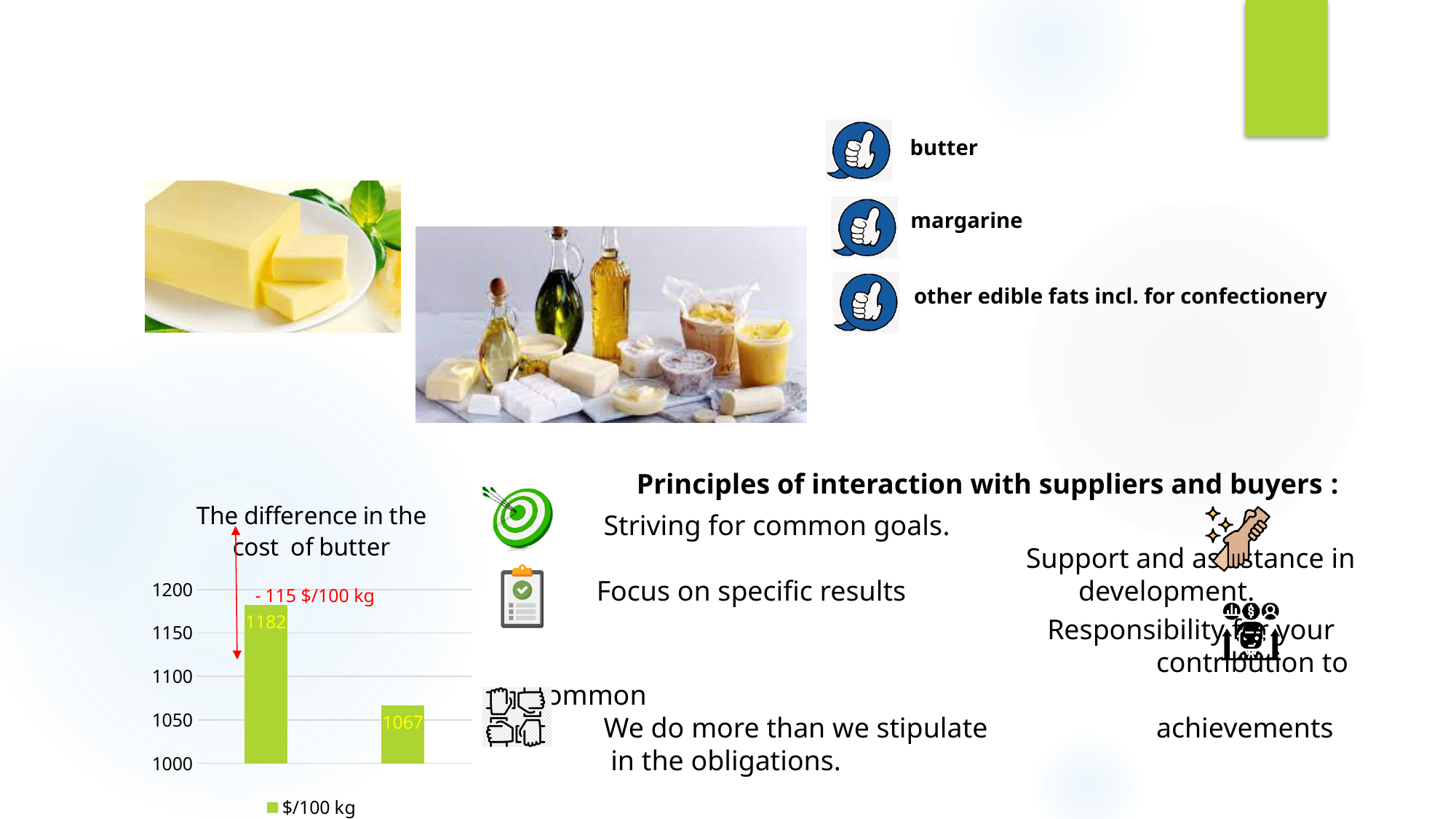
Which bar is taller, the left bar or the right bar? the left bar How many bars are plotted in the chart? 2 How many series does the chart legend list? 1 What is the value of the right bar in the chart? 1067 Do the bar values rise or fall from left to right in the chart? fall What type of chart is shown on the slide? bar chart Is the value of the right bar greater or less than 1100? less What is the title of the chart on the slide? The difference in the cost of butter Is the value of the left bar greater or less than 1150? greater What is the value of the left bar in the chart? 1182 What is the legend entry of the chart? $/100 kg What is the difference between the left bar (1182) and the right bar (1067)? 115